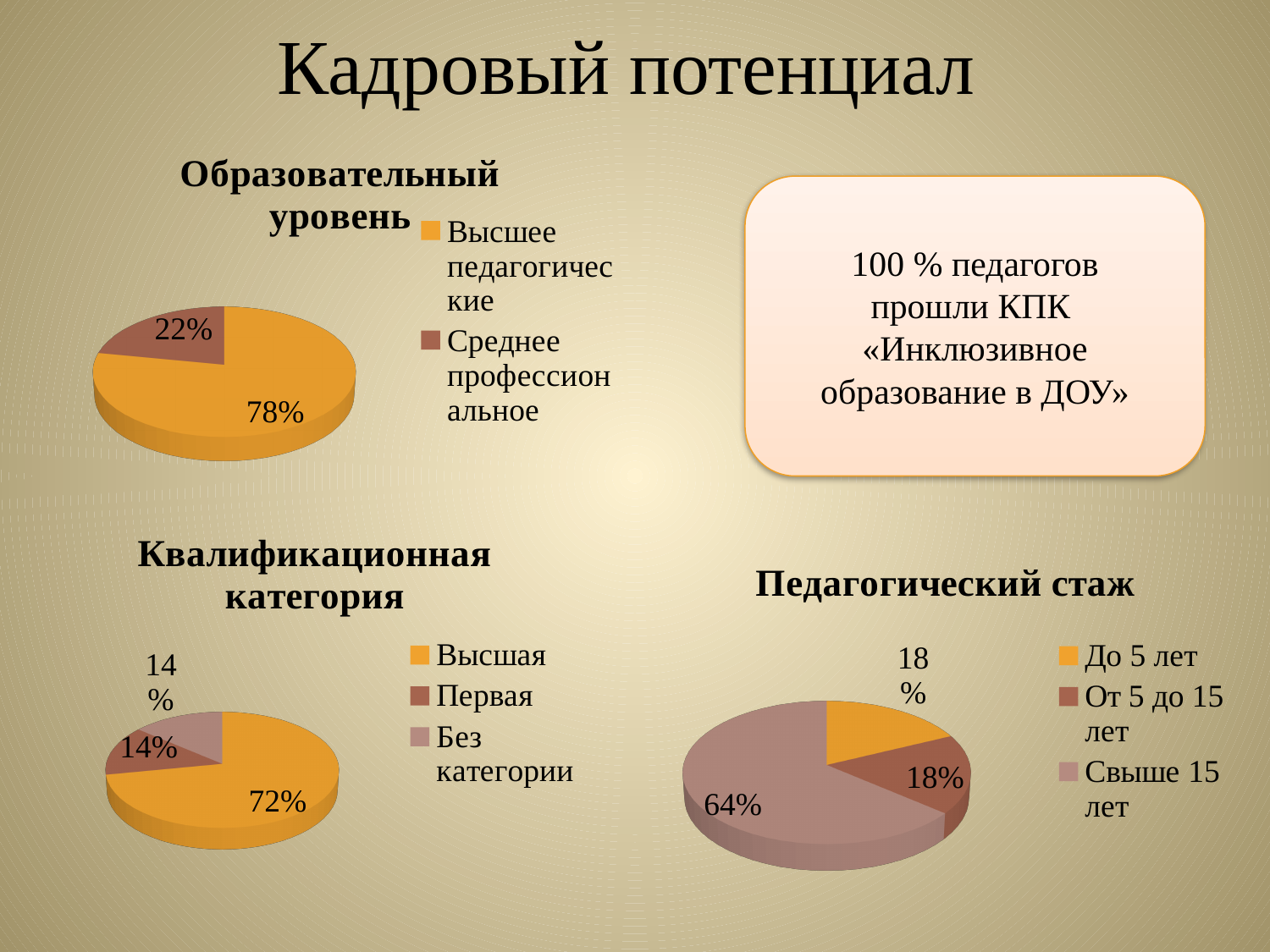
What kind of chart is the «Образовательный уровень» chart? Pie chart In the chart titled «Квалификационная категория», what is the difference between the «Высшая» share and the «Первая» share? 58% In the chart titled «Квалификационная категория», how many categories does the legend list? 3 In the chart titled «Квалификационная категория», which category has the largest share? Высшая In the chart titled «Педагогический стаж», what is the combined share of «До 5 лет» and «От 5 до 15 лет»? 36% In the chart titled «Педагогический стаж», which category has the largest share? Свыше 15 лет In the chart titled «Образовательный уровень», what share of teachers have «Высшее педагогические» education? 78% In the chart titled «Педагогический стаж», what share is «До 5 лет»? 18% In the chart titled «Квалификационная категория», what share is «Высшая»? 72% How many pie charts are shown on the slide? 3 In the chart titled «Педагогический стаж», what share of teachers have «Свыше 15 лет» of experience? 64% In the chart titled «Образовательный уровень», what share is labelled «Среднее профессиональное»? 22%